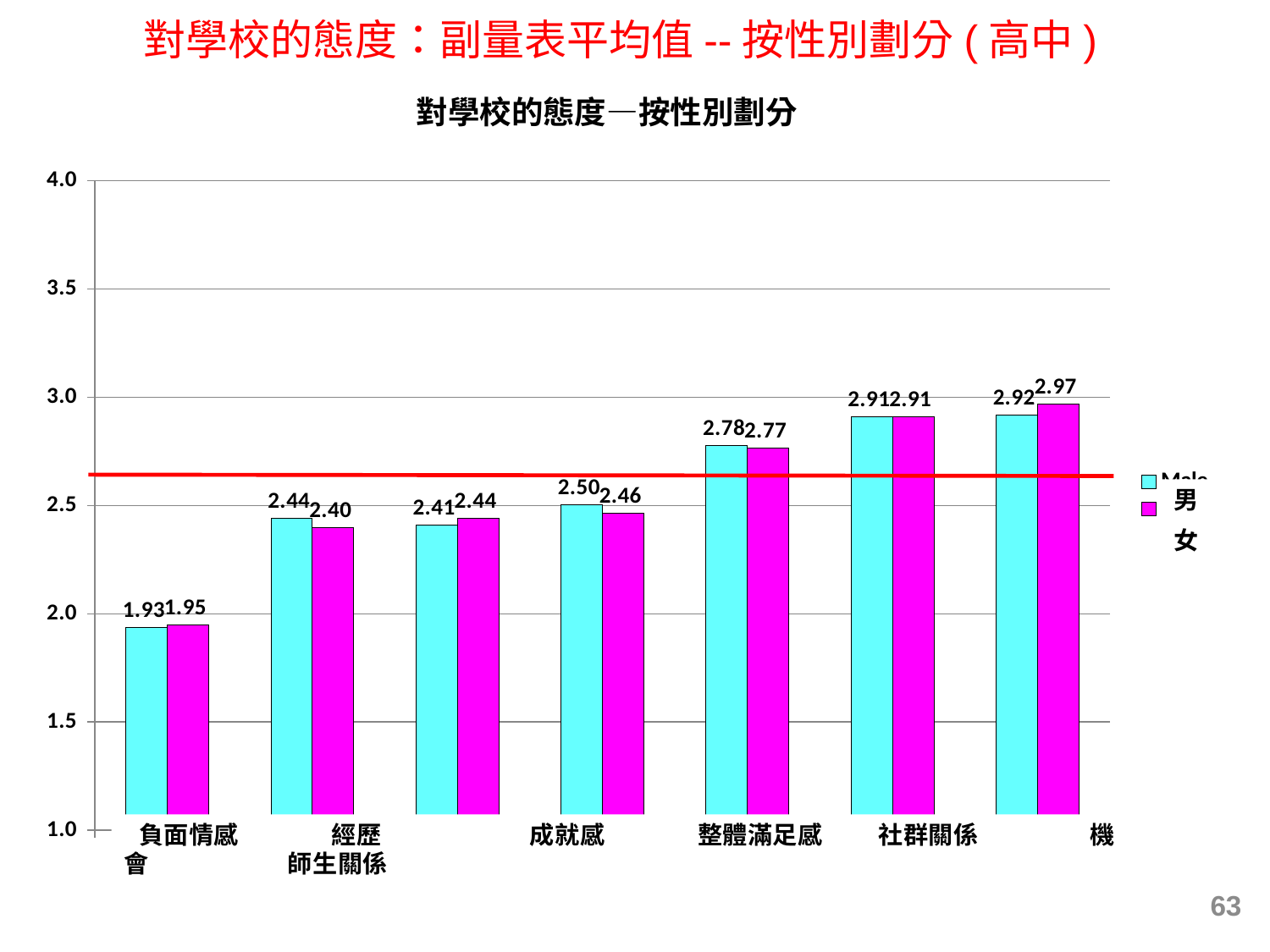
Which category has the lowest value for 男? 負面情感 What kind of chart is shown on the slide? bar chart What is the value for 男 in the 整體滿足感 category? 2.78 What is the value for 女 in the 社群關係 category? 2.91 What is the difference between the 男 and 女 values in the 成就感 category? 0.04 What is the value for 男 in the 成就感 category? 2.50 What is the value for 女 in the 負面情感 category? 1.95 How many category groups of bars are plotted in the chart? 7 Is the value for 女 in the 整體滿足感 category greater or less than 2.5? greater What is the value for 男 in the 負面情感 category? 1.93 How many series does the legend list? 2 In the 整體滿足感 category, what is the difference between the 男 and 女 values? 0.01